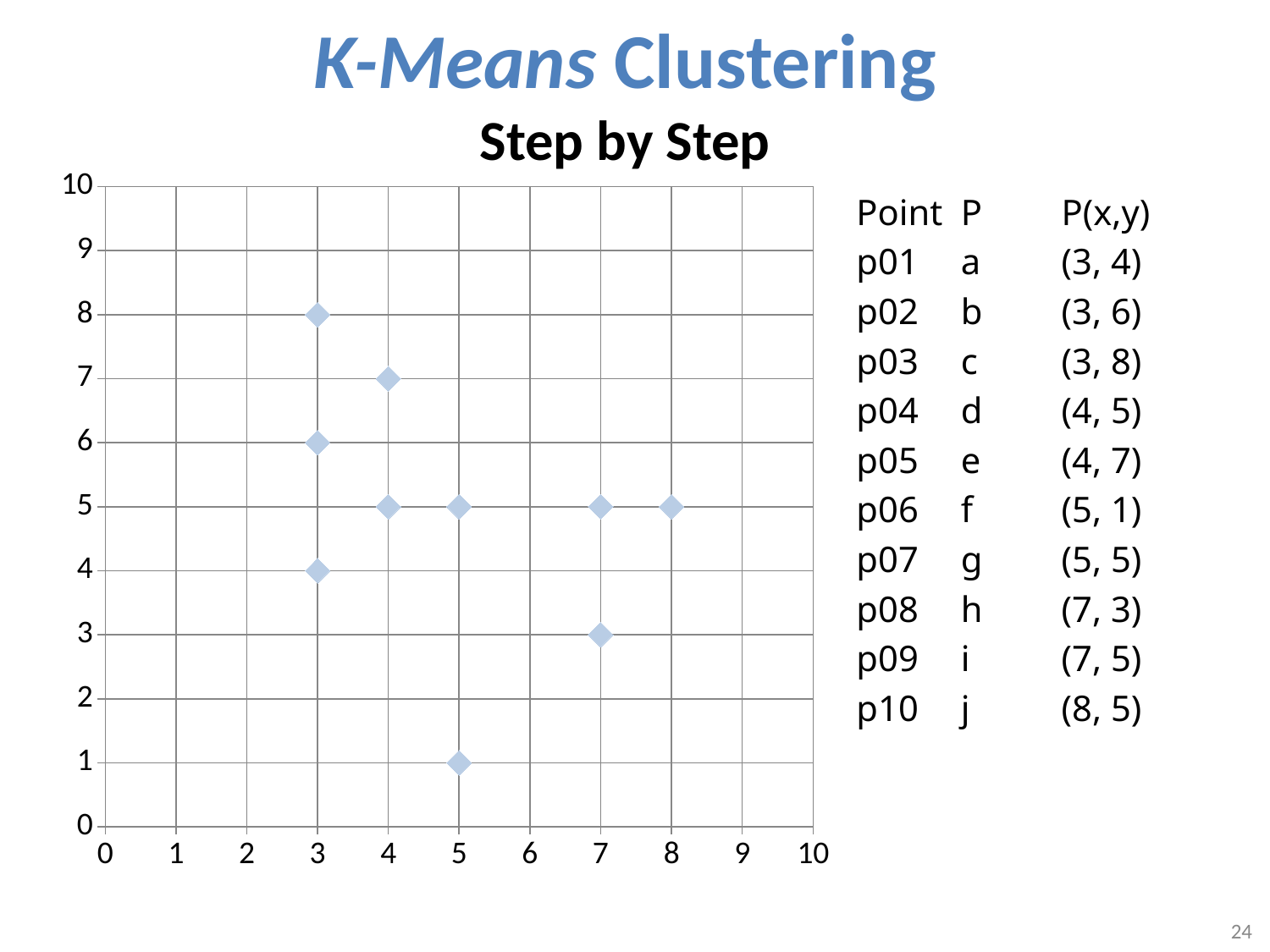
How many data points are plotted on the chart? 10 What is the y value of the point plotted at x = 8? 5 What is the smallest x value among the plotted points? 3 What is the lowest y value among the plotted points? 1 How many points are plotted at x = 3? 3 What is the maximum value shown on the x axis? 10 What is the difference between the highest and lowest y values of the plotted points? 7 What kind of chart is shown on the slide? scatter chart How many points are plotted at y = 5? 4 Is the y value of the lowest point at x = 5 greater or less than 2? less What is the highest y value among the plotted points? 8 What is the largest x value among the plotted points? 8